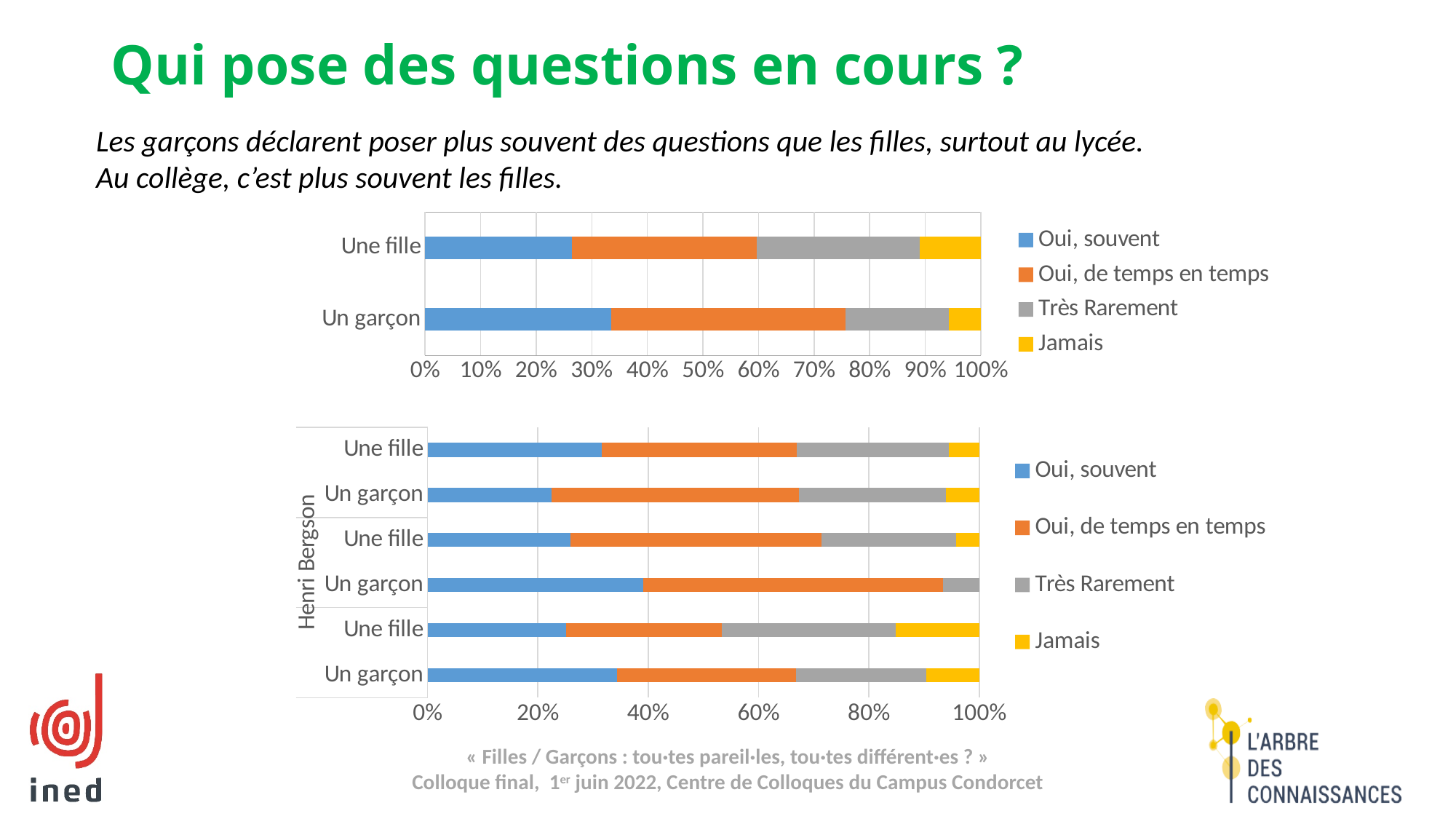
In the bottom chart, which bar has the largest 'Jamais' segment? Une fille (fifth bar from the top) In the top chart, which category has the larger 'Jamais' segment, 'Une fille' or 'Un garçon'? Une fille How many bars (categories) are plotted in the bottom chart? 6 What kind of chart is the top chart on the slide? Stacked bar chart How many bars (categories) are plotted in the top chart? 2 In the top chart, is the 'Oui, souvent' value for 'Une fille' greater or less than 30%? less In the bottom chart, what colour represents the 'Jamais' series? Yellow In the top chart, which category has the larger 'Oui, souvent' segment, 'Une fille' or 'Un garçon'? Un garçon What label appears on the vertical axis of the bottom chart? Henri Bergson In the bottom chart, is the 'Oui, souvent' value for the fourth bar from the top ('Un garçon') greater or less than 20%? greater In the top chart, is the 'Oui, souvent' value for 'Un garçon' greater or less than 20%? greater How many series does the legend of the top chart list? 4